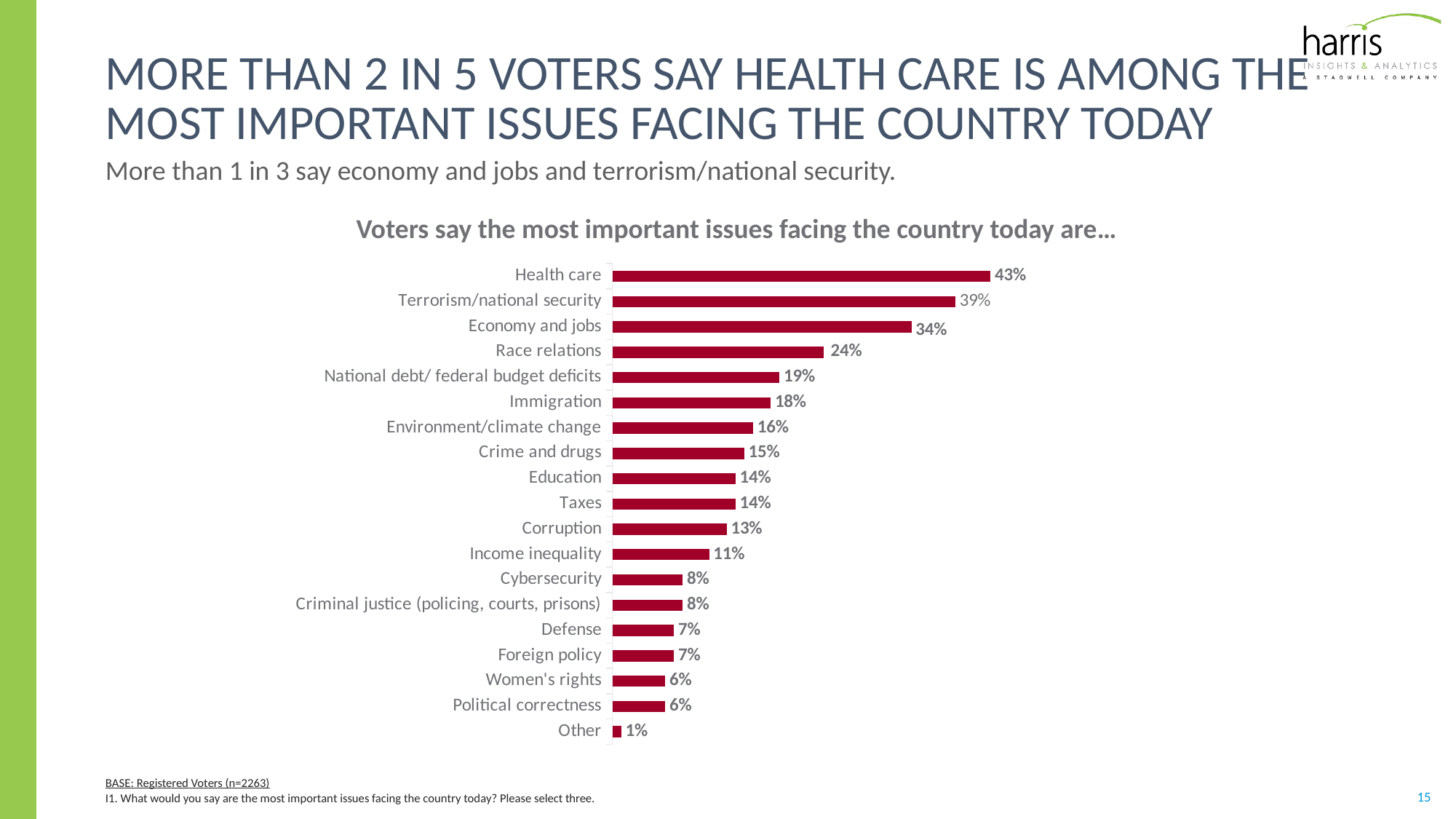
What type of chart is shown on the slide? Bar chart Which has a higher percentage, Corruption or Cybersecurity? Corruption What is the title of the chart? Voters say the most important issues facing the country today are… What percentage of voters say health care is among the most important issues facing the country today? 43% What is the difference between the percentages for Health care and Economy and jobs? 9% Which category has the lowest percentage in the chart? Other Which has a higher percentage, Race relations or National debt/ federal budget deficits? Race relations How many issue categories are shown in the chart? 19 What is the difference between the values for Terrorism/national security and Immigration? 21% Which issue has the highest percentage in the chart? Health care What percentage is shown for Income inequality? 11% What is the value shown for Race relations? 24%